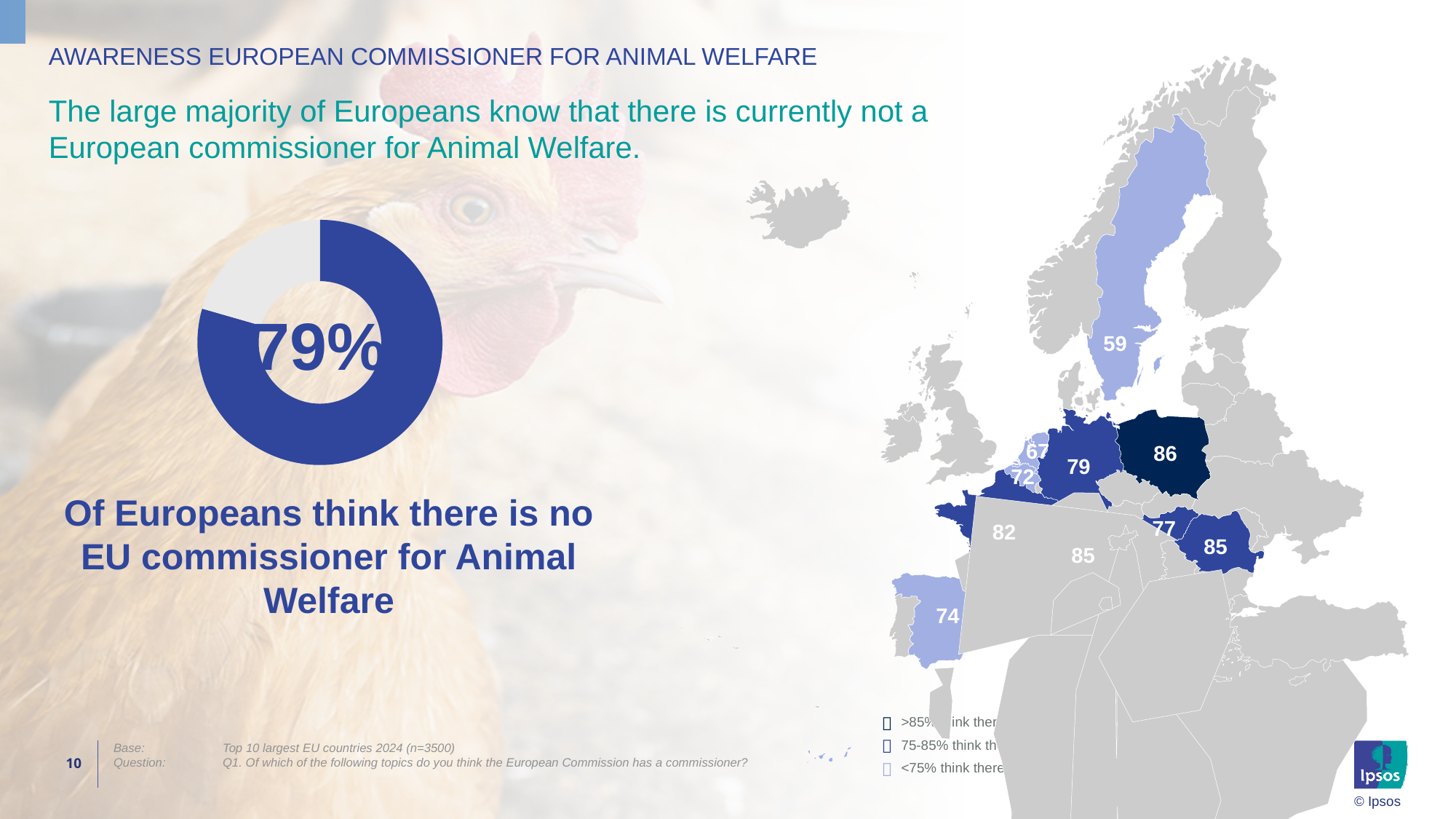
What percentage is shown in the centre of the donut chart? 79% On the map, what is the highest value printed on any country? 86 What kind of chart is used on the left of the slide to show the 79% figure? Donut chart How many countries on the map have a value printed on them? 10 On the map, what is the lowest value printed on any country? 59 On the map, which value is printed on the country shaded in the darkest blue? 86 Is the value shown in the donut chart greater or less than 50%? greater What is the title of the slide containing the donut chart and map? AWARENESS EUROPEAN COMMISSIONER FOR ANIMAL WELFARE In the donut chart, is the blue segment larger or smaller than the grey segment? Larger What is the difference between the highest (86) and lowest (59) values printed on the map? 27 According to the donut chart, what share of Europeans think there is no EU commissioner for Animal Welfare? 79% How many categories does the map legend list? 3